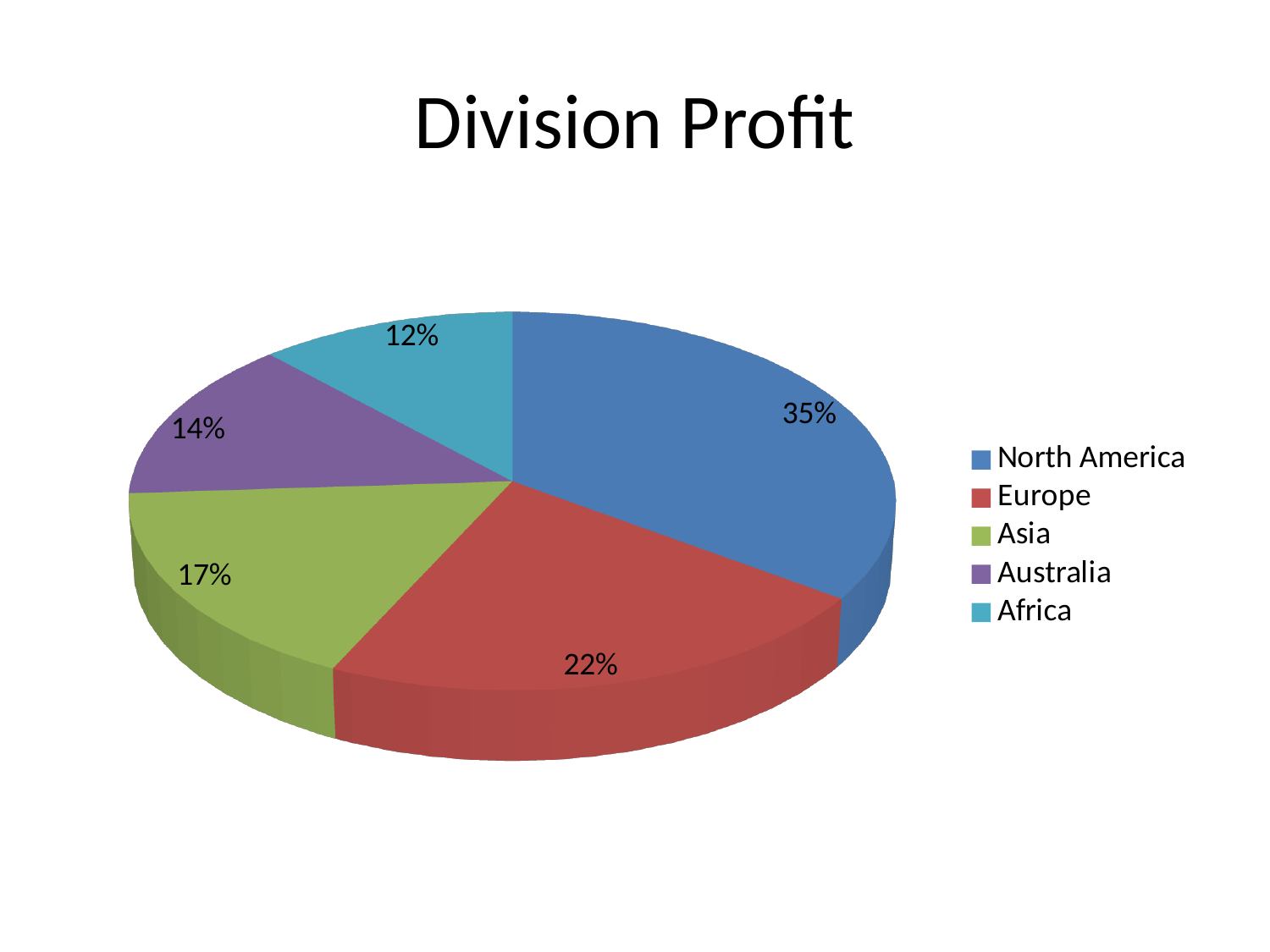
What is the title of the chart? Division Profit How many slices does the pie chart have? 5 What share of the pie does Asia have? 17% What is the difference between the shares of North America and Europe? 13% Which has a larger share, Asia or Australia? Asia Which division has the smallest share of the pie? Africa What share of the pie does Europe have? 22% What kind of chart is shown on the slide? pie chart What share of the pie does North America have? 35% Which division has the largest share of the pie? North America